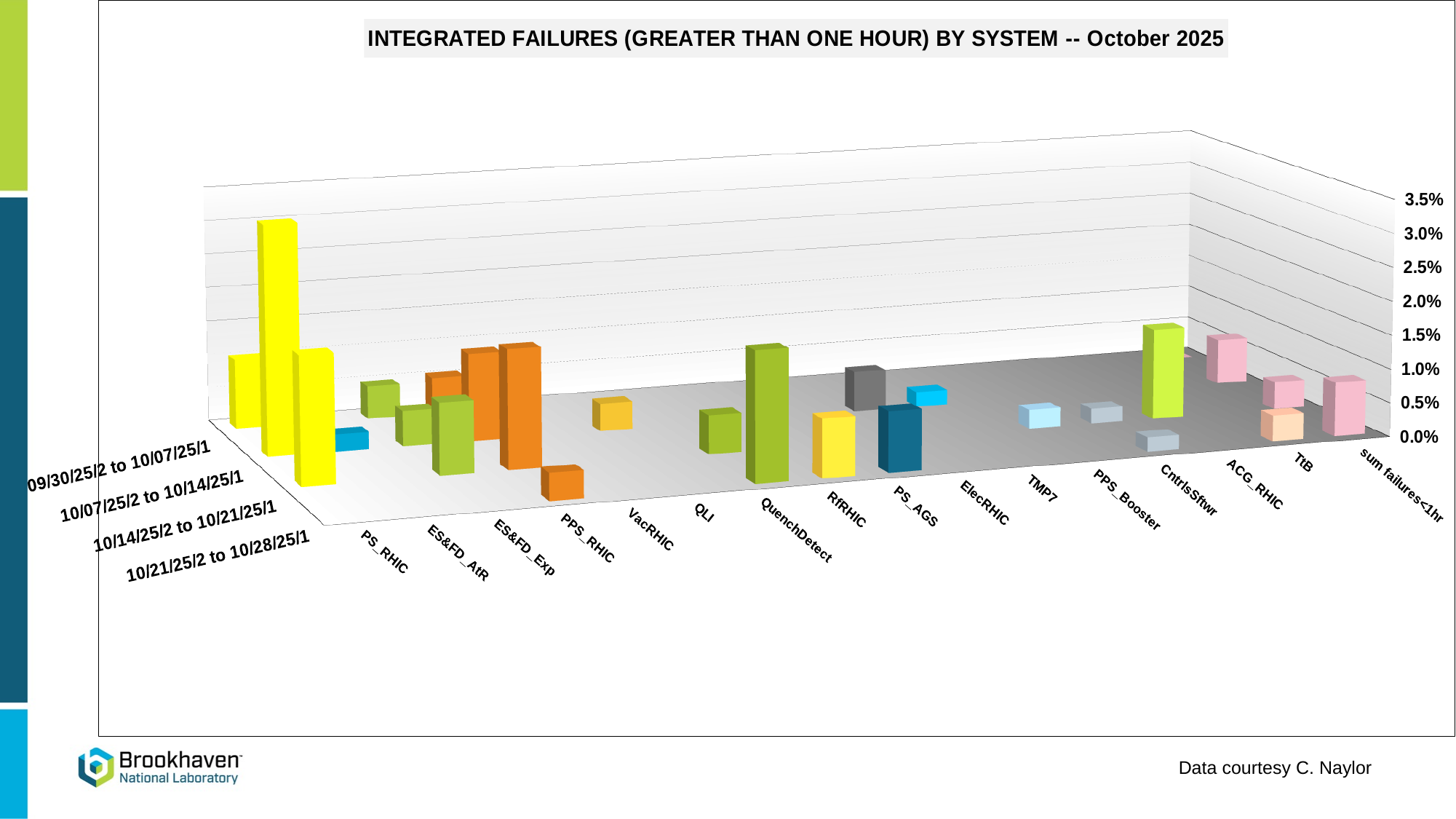
Is the tallest bar for ES&FD_Exp greater or less than 2.0%? less What is the title of the chart? INTEGRATED FAILURES (GREATER THAN ONE HOUR) BY SYSTEM -- October 2025 Which system has the tallest bar in the chart? PS_RHIC Is the tallest bar for PS_RHIC greater or less than 2.0%? greater Which is larger: the tallest bar for PS_RHIC or the tallest bar for QuenchDetect? PS_RHIC How many systems (categories) are listed along the horizontal axis of the chart? 16 Is the tallest bar for TMP7 greater or less than 1.0%? less What is the label of the first time period on the depth axis? 09/30/25/2 to 10/07/25/1 What is the highest value labelled on the vertical axis? 3.5% What kind of chart is shown on the slide? bar chart How many weekly time periods are shown along the depth axis of the chart? 4